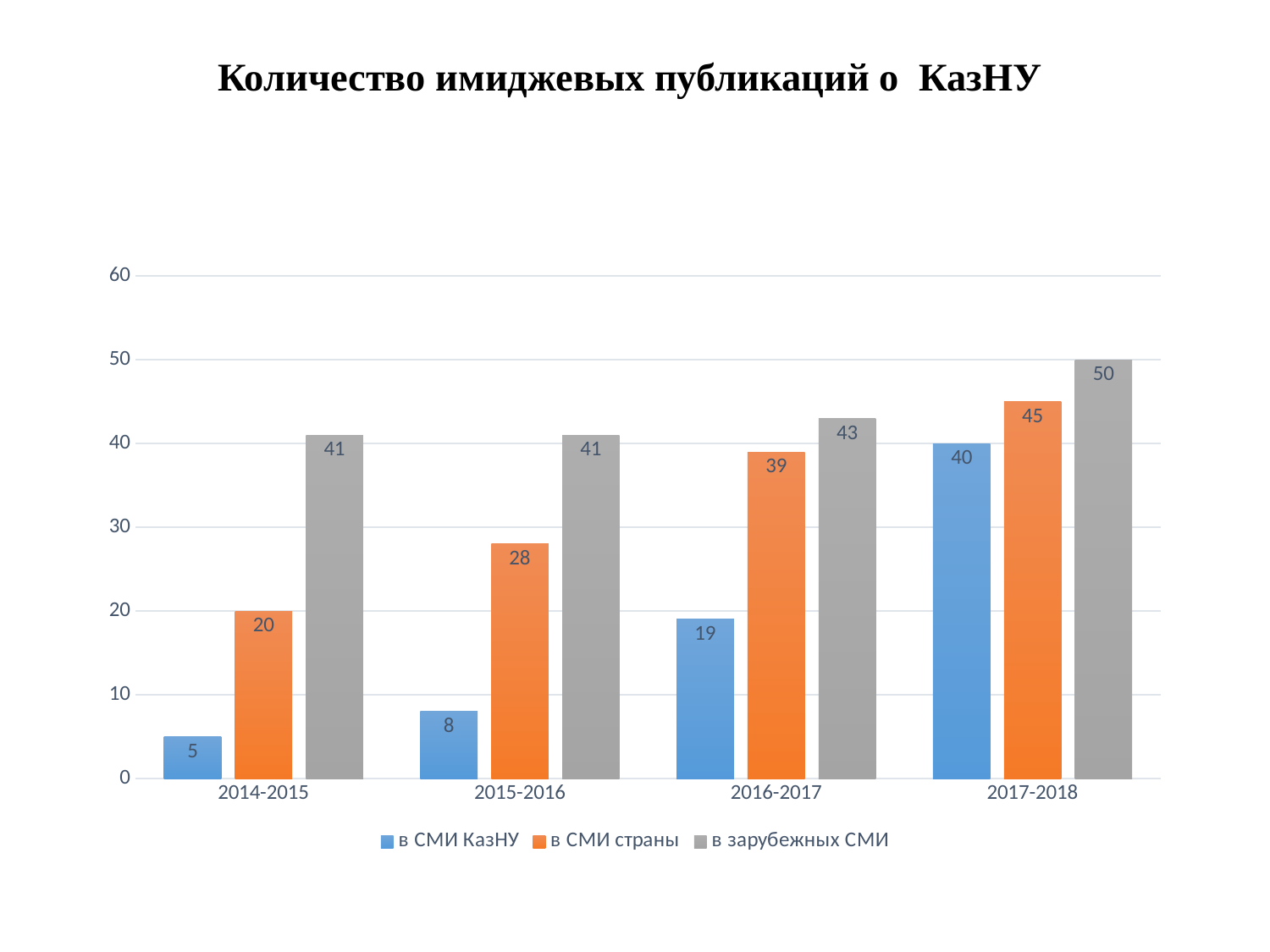
Which period has the highest value for "в СМИ КазНУ"? 2017-2018 How many periods are shown on the x axis? 4 What is the title of the chart? Количество имиджевых публикаций о КазНУ Which period has the lowest value for "в СМИ страны"? 2014-2015 What is the value for "в СМИ КазНУ" in 2014-2015? 5 Do the values for "в СМИ КазНУ" rise or fall from 2014-2015 to 2017-2018? rise How many series does the legend list? 3 What is the value for "в СМИ страны" in 2016-2017? 39 Which is larger in 2017-2018: "в СМИ КазНУ" or "в СМИ страны"? в СМИ страны What is the value for "в зарубежных СМИ" in 2017-2018? 50 What is the difference between "в зарубежных СМИ" and "в СМИ КазНУ" in 2015-2016? 33 What kind of chart is shown on the slide? bar chart